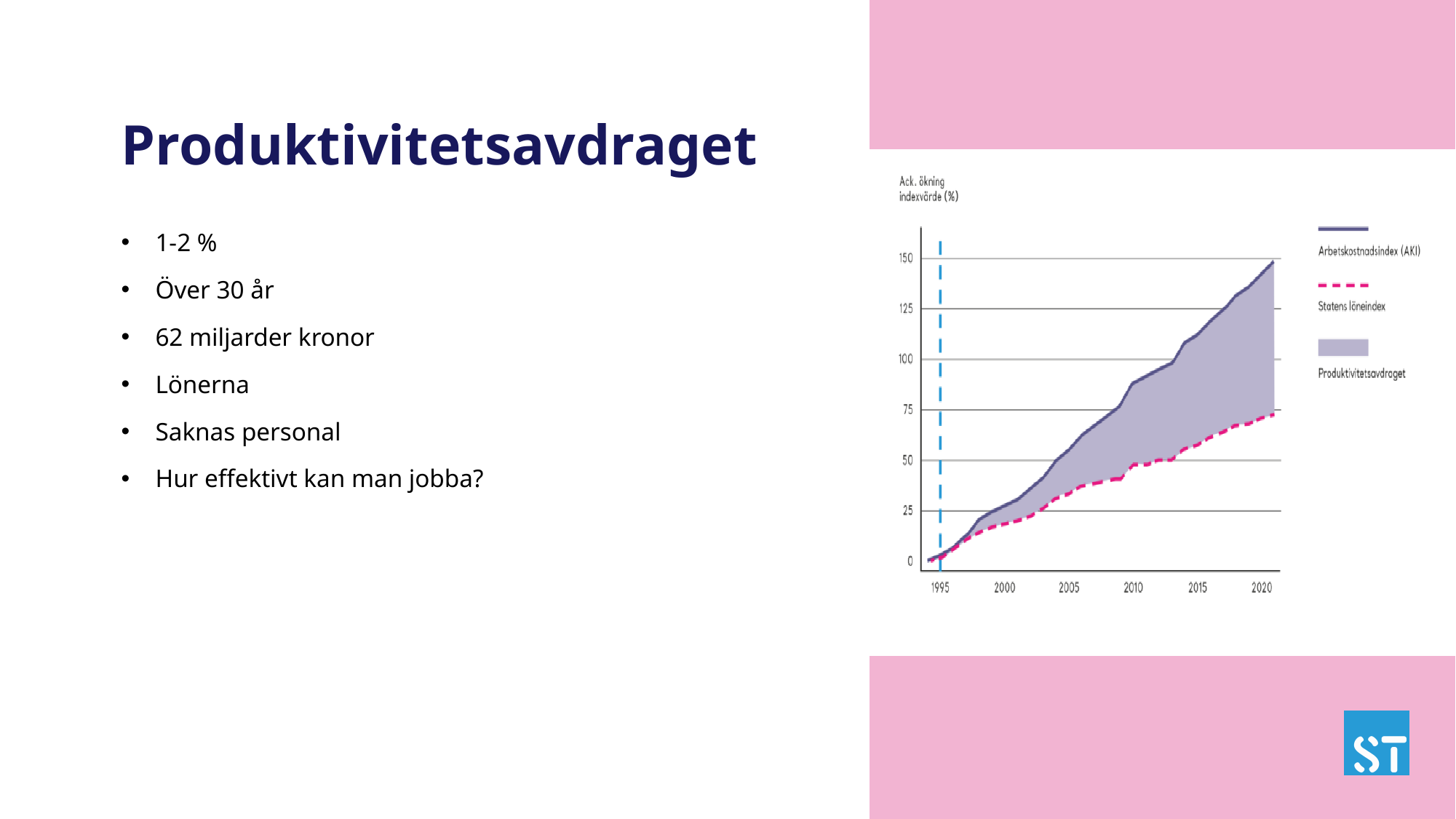
Which series is drawn as a pink dashed line? Statens löneindex How many entries does the chart's legend list? 3 What does the shaded area between the two lines represent? Produktivitetsavdraget Do the values of Arbetskostnadsindex (AKI) rise or fall from 1995 to 2020? rise Is the value of Statens löneindex in 2015 greater or less than 75? less Is the value of Statens löneindex in 2020 greater or less than 50? greater What kind of chart is shown on the slide? line chart In 2020, which is larger: Arbetskostnadsindex (AKI) or Statens löneindex? Arbetskostnadsindex (AKI) Is the value of Arbetskostnadsindex (AKI) in 2020 greater or less than 125? greater